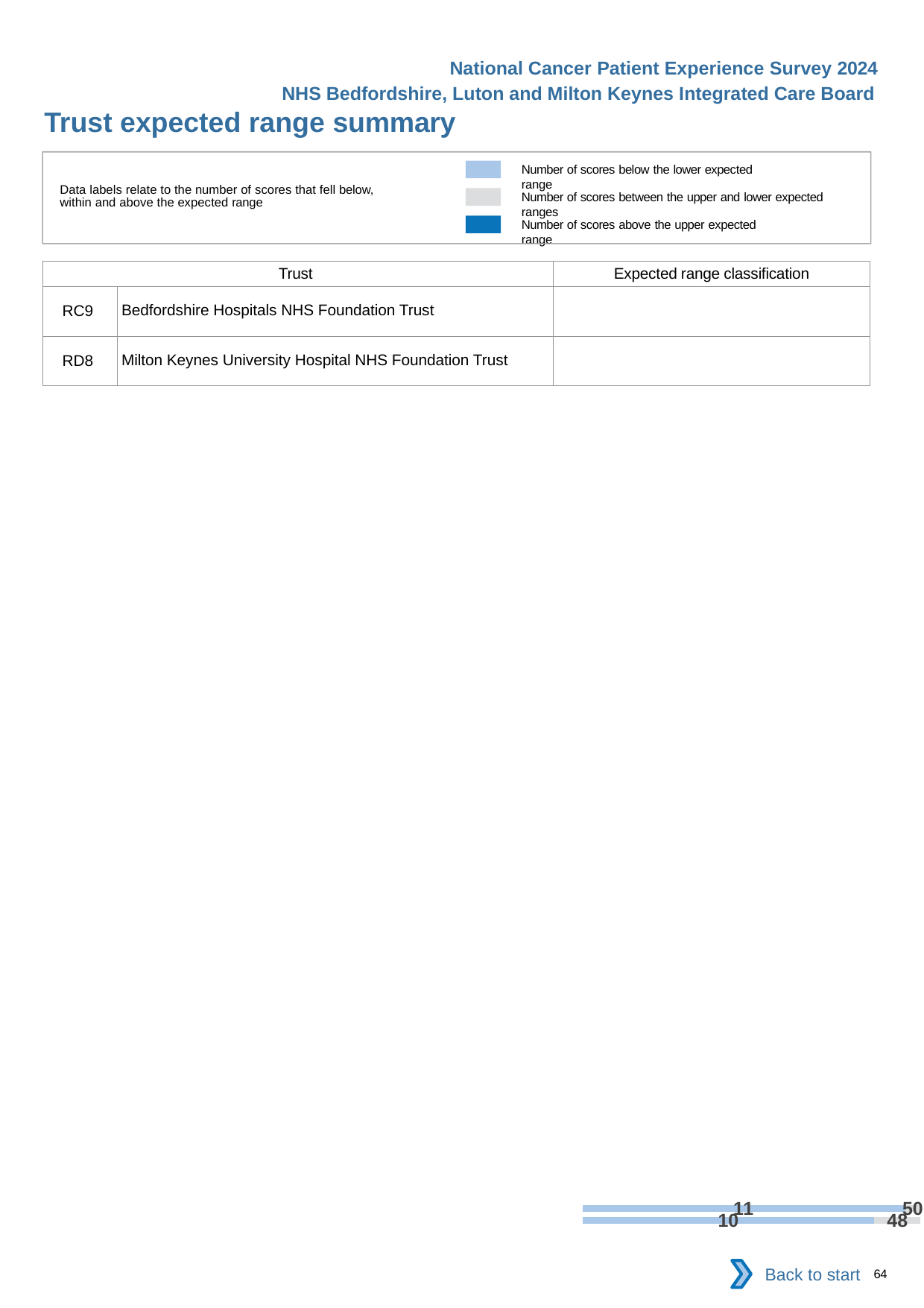
In the chart at the bottom of the slide, what value is labelled on the light blue segment of the upper bar? 11 How many categories does the legend in the key box list? 3 According to the key, what does the dark blue colour represent? Number of scores above the upper expected range In the chart at the bottom of the slide, what is the difference between the grey segment values of the upper bar and the lower bar? 2 What kind of chart is shown at the bottom of the slide? bar chart In the chart at the bottom of the slide, what is the total of the labelled values on the upper bar? 61 How many bars are plotted in the chart at the bottom of the slide? 2 In the chart at the bottom of the slide, what value is labelled on the light blue segment of the lower bar? 10 In the chart at the bottom of the slide, what value is labelled on the grey segment of the upper bar? 50 In the chart at the bottom of the slide, what is the total of the labelled values on the lower bar? 58 In the chart at the bottom of the slide, what value is labelled on the grey segment of the lower bar? 48 In the chart at the bottom of the slide, which bar has the larger grey segment value, the upper bar or the lower bar? the upper bar